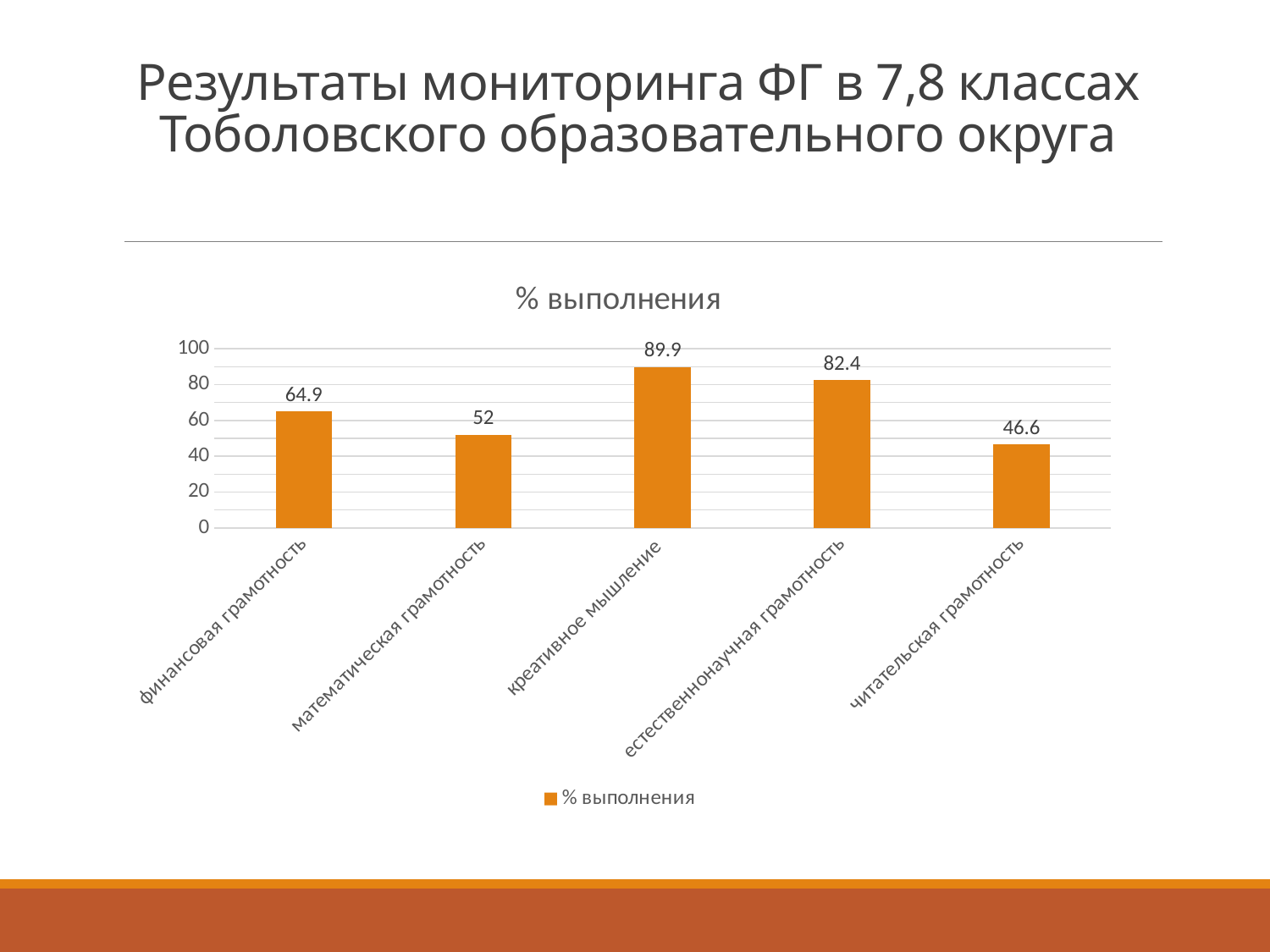
How many series does the legend list? 1 Is the value for естественнонаучная грамотность greater or less than 80? greater What is the value for математическая грамотность? 52 What is the difference between the values for креативное мышление and естественнонаучная грамотность? 7.5 What is the title of the chart? % выполнения Which category has the highest value? креативное мышление What kind of chart is shown? bar chart What is the value for финансовая грамотность? 64.9 Which is larger, the value for финансовая грамотность or математическая грамотность? финансовая грамотность What is the value for читательская грамотность? 46.6 How many categories are shown on the x axis? 5 Which category has the lowest value? читательская грамотность